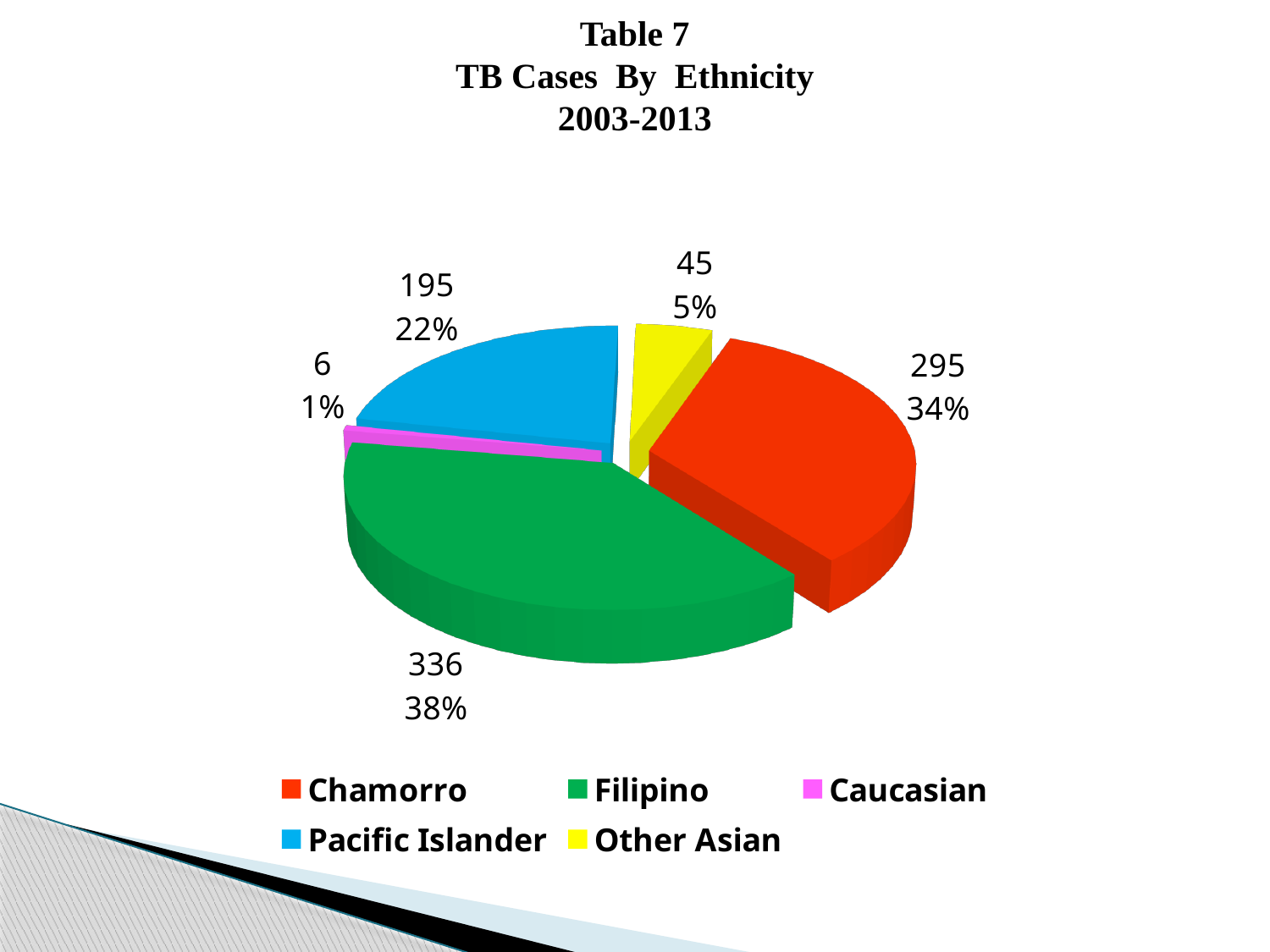
How many TB cases are shown for Other Asian? 45 Which has more TB cases, Pacific Islander or Other Asian? Pacific Islander What type of chart is shown on the slide? Pie chart How many ethnicity categories does the legend list? 5 How many TB cases are shown for Filipino? 336 How many TB cases are shown for Pacific Islander? 195 Which ethnicity has the lowest number of TB cases? Caucasian Which ethnicity has the highest number of TB cases? Filipino What is the difference in TB cases between Filipino and Chamorro? 41 What share of the pie does Caucasian represent? 1% What share of the pie does Pacific Islander represent? 22% How many TB cases are shown for Chamorro? 295